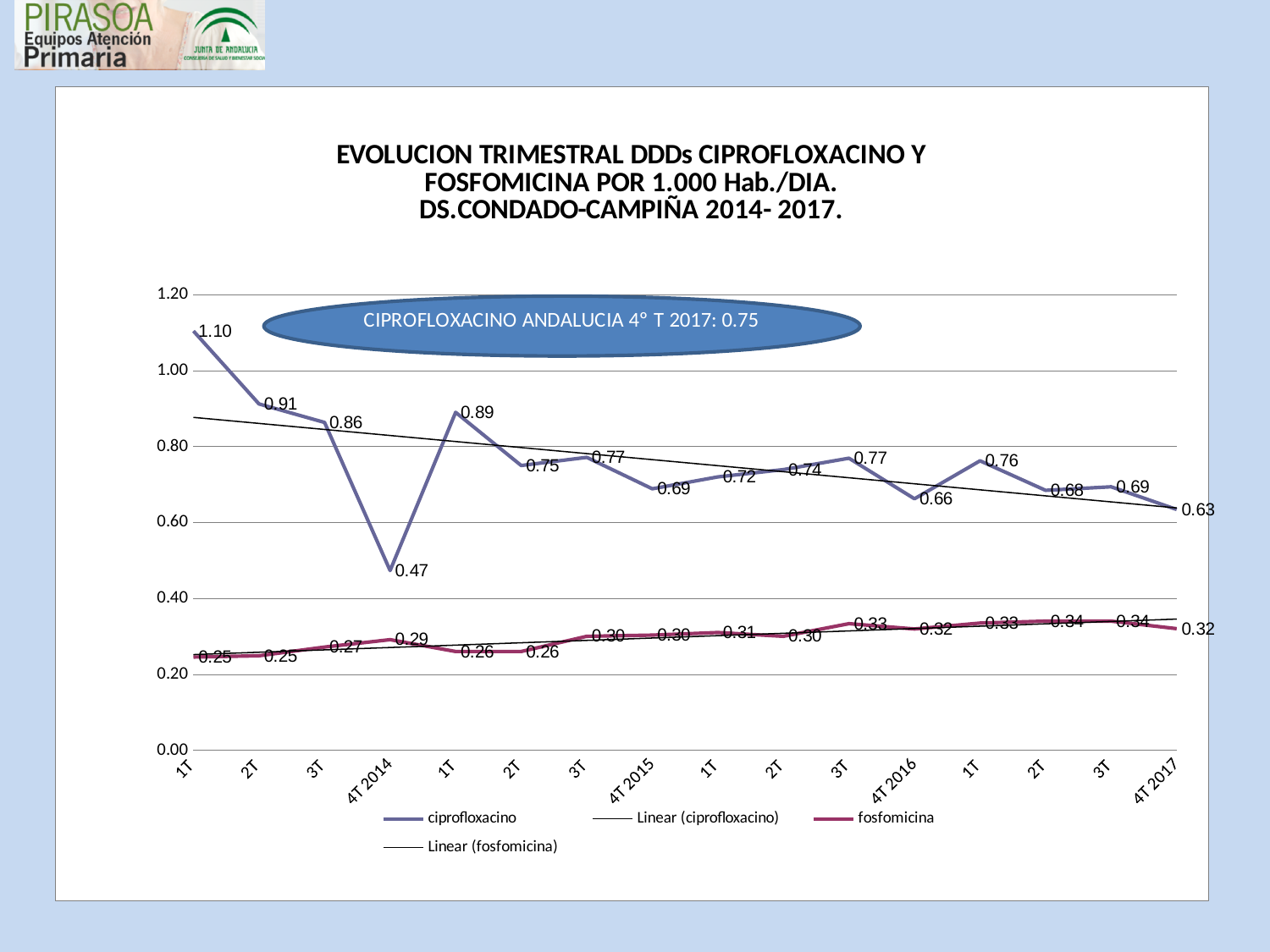
What is the fosfomicina value for 4T 2017? 0.32 What is the ciprofloxacino value for 4T 2014? 0.47 What kind of chart is shown on the slide? line chart Does the fosfomicina series generally rise or fall from 1T 2014 to 4T 2017? rise How many quarters are plotted on the x axis? 16 What is the difference between the ciprofloxacino value in 1T 2014 and in 4T 2017? 0.47 Which is larger, the ciprofloxacino value in 1T 2015 or in 2T 2015? 1T 2015 How many entries does the legend list? 4 Is the ciprofloxacino value for 4T 2014 greater or less than 0.60? less In which quarter is the ciprofloxacino value lowest? 4T 2014 What is the ciprofloxacino value for 4T 2017? 0.63 In which quarter is the ciprofloxacino value highest? 1T 2014